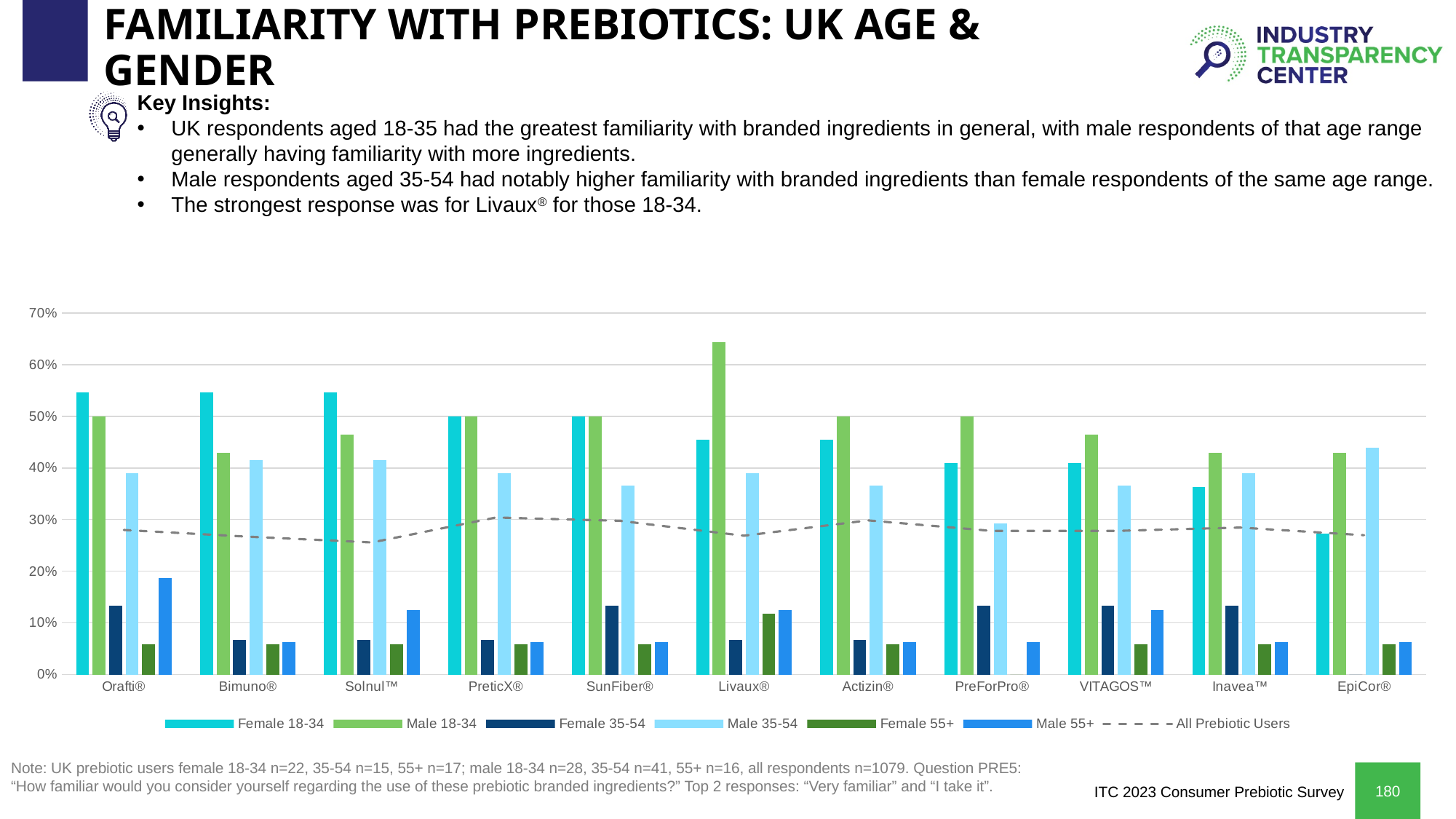
Is the Male 35-54 value for EpiCor® greater or less than 40%? greater For Bimuno®, which is larger: the Female 18-34 value or the Male 35-54 value? Female 18-34 Is the Female 55+ value for Orafti® greater or less than 10%? less Is the Male 18-34 value for Livaux® greater or less than 60%? greater What kind of chart is shown on the slide? combination bar and line chart Which series is plotted as the dashed line? All Prebiotic Users For which ingredient is the Female 18-34 bar the lowest? EpiCor® For Livaux®, which is larger: the Male 18-34 value or the Female 18-34 value? Male 18-34 How many series does the legend list? 7 How many branded ingredients (categories) are shown on the x axis? 11 For which ingredient is the Male 18-34 bar the highest? Livaux®